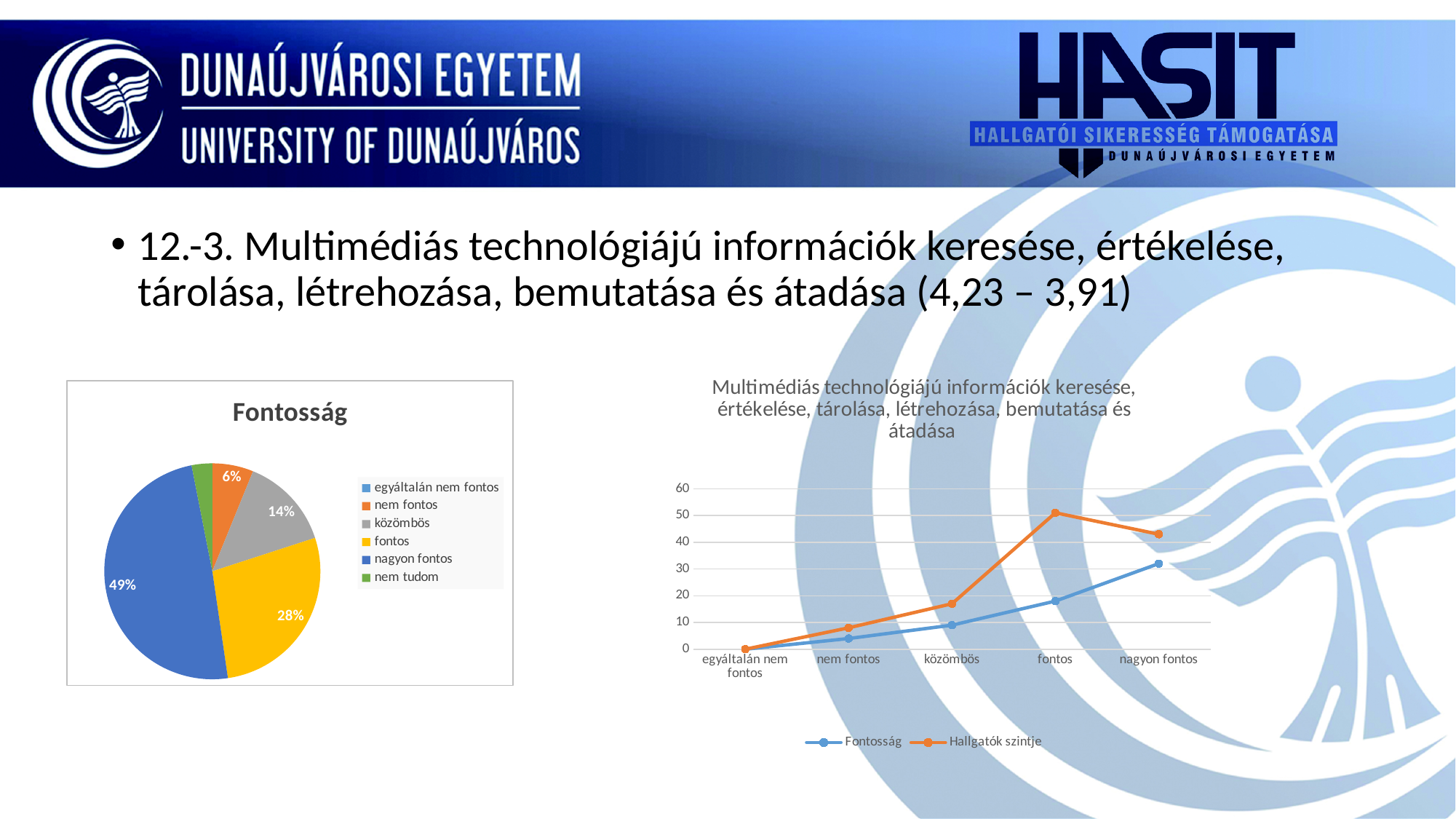
In the line chart on the right, how many categories are shown on the x axis? 5 In the pie chart titled "Fontosság", how many entries does the legend list? 6 In the pie chart titled "Fontosság", what percentage is shown for "fontos"? 28% In the pie chart titled "Fontosság", what is the difference in percentage points between "nagyon fontos" and "fontos"? 21 In the line chart on the right, at the category "fontos", which series has the larger value, "Fontosság" or "Hallgatók szintje"? Hallgatók szintje In the line chart on the right, how many series does the legend list? 2 In the line chart on the right, which category has the highest value for the "Hallgatók szintje" series? fontos In the pie chart titled "Fontosság", what percentage is shown for "közömbös"? 14% In the pie chart titled "Fontosság", which category has the largest slice? nagyon fontos In the pie chart titled "Fontosság", what percentage is shown for "nagyon fontos"? 49% In the pie chart titled "Fontosság", what percentage is shown for "nem fontos"? 6%